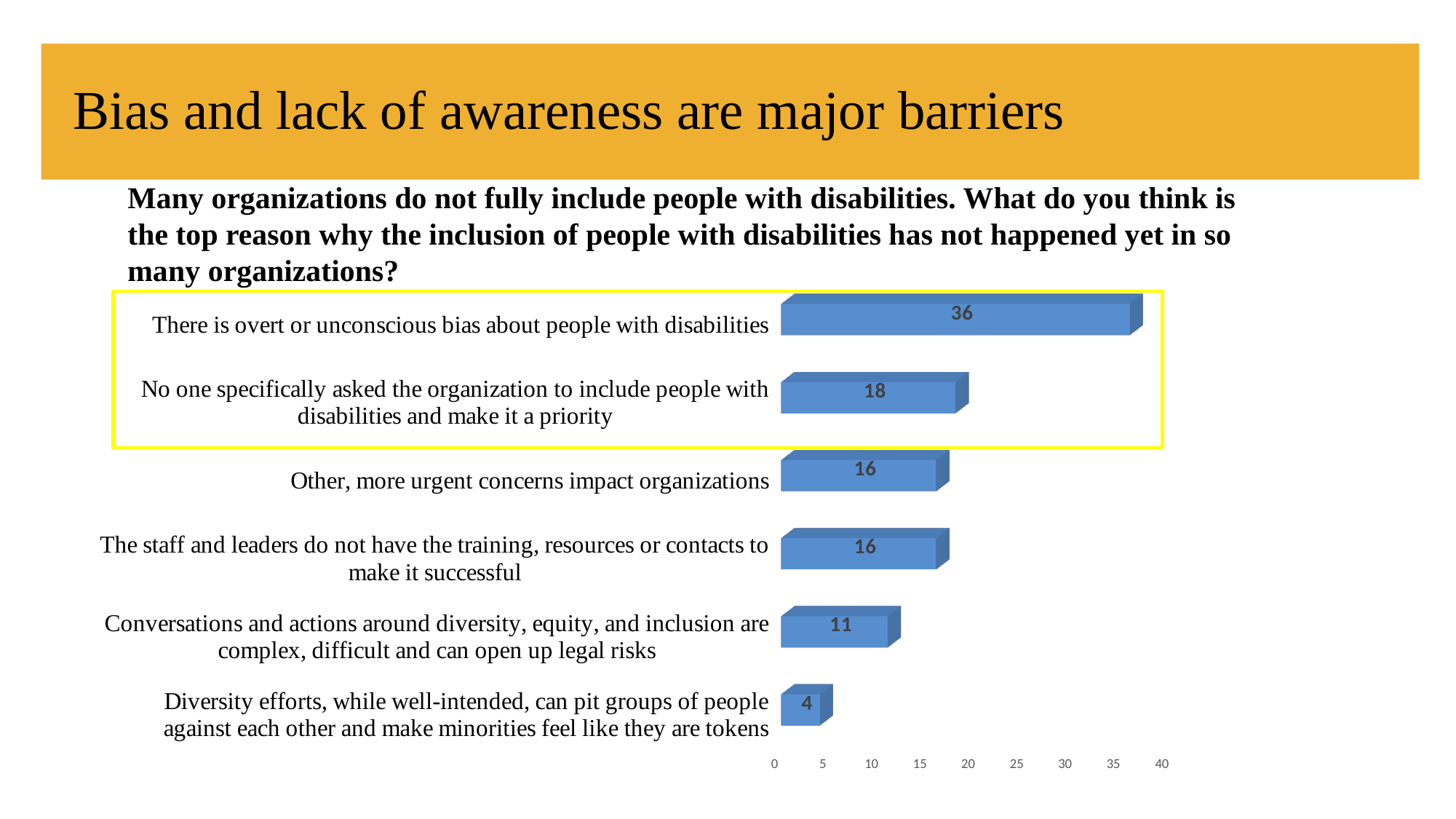
What is the difference between the value for "There is overt or unconscious bias about people with disabilities" and the value for "No one specifically asked the organization to include people with disabilities and make it a priority"? 18 What is the value for "There is overt or unconscious bias about people with disabilities"? 36 What is the value for "Conversations and actions around diversity, equity, and inclusion are complex, difficult and can open up legal risks"? 11 Which is larger: the value for "Other, more urgent concerns impact organizations" or the value for "Conversations and actions around diversity, equity, and inclusion are complex, difficult and can open up legal risks"? Other, more urgent concerns impact organizations What kind of chart is shown on the slide? Bar chart Which category has the highest value? There is overt or unconscious bias about people with disabilities What is the value for "No one specifically asked the organization to include people with disabilities and make it a priority"? 18 How many categories are shown in the chart? 6 What is the highest value shown on the horizontal axis? 40 What is the value for "Diversity efforts, while well-intended, can pit groups of people against each other and make minorities feel like they are tokens"? 4 Which category has the lowest value? Diversity efforts, while well-intended, can pit groups of people against each other and make minorities feel like they are tokens Is the value for "There is overt or unconscious bias about people with disabilities" greater or less than 30? greater